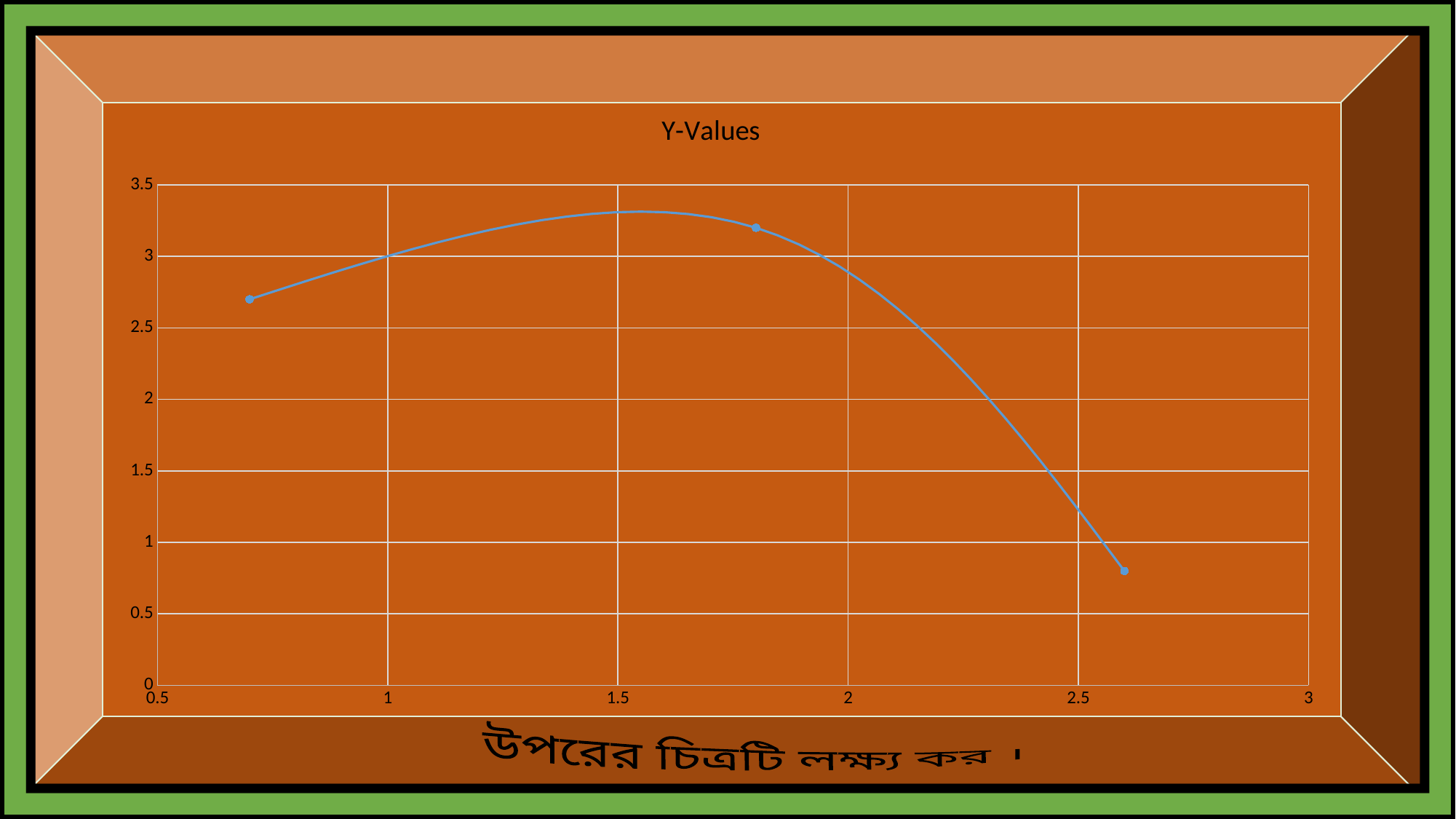
Is the value of the middle data point (near x = 1.8) greater or less than 3? greater Which has the larger y-value, the leftmost data point or the rightmost data point? the leftmost data point How do the y-values change as x increases along the chart? They rise and then fall Is the value of the rightmost data point (near x = 2.6) greater or less than 1? less What is the highest value shown on the vertical axis? 3.5 Which data point has the lowest y-value: the leftmost, the middle, or the rightmost? the rightmost What kind of chart is shown on the slide? Scatter chart with a smooth line What is the title of the chart? Y-Values Is the value of the rightmost data point (near x = 2.6) greater or less than 0.5? greater Which data point has the highest y-value: the leftmost, the middle, or the rightmost? the middle How many data points are plotted on the chart? 3